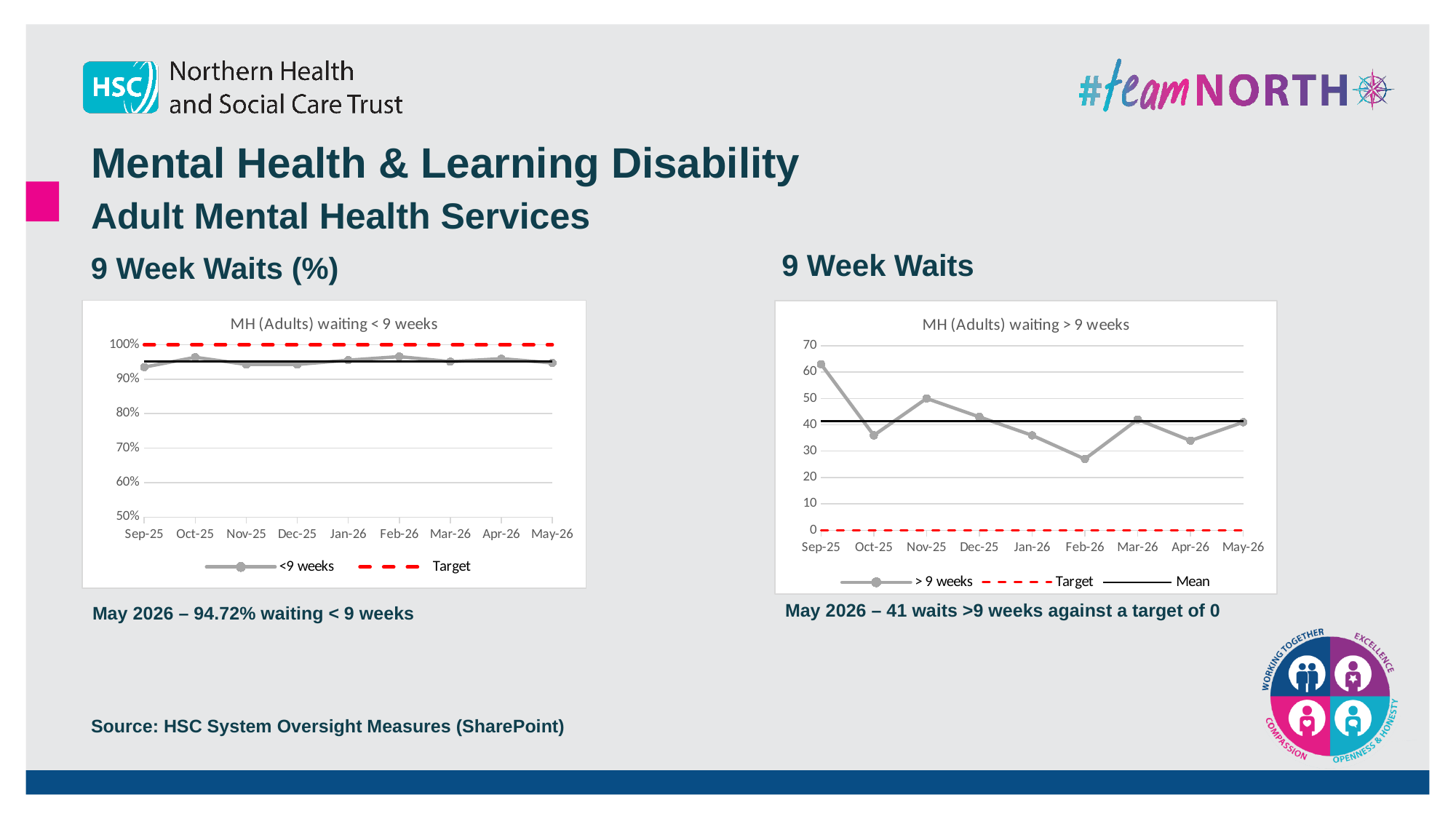
How many series does the legend of the 'MH (Adults) waiting < 9 weeks' chart list? 2 In the 'MH (Adults) waiting > 9 weeks' chart, which month has the highest number of waits? Sep-25 In the 'MH (Adults) waiting > 9 weeks' chart, which month has the lowest number of waits? Feb-26 How many series does the legend of the 'MH (Adults) waiting > 9 weeks' chart list? 3 In the 'MH (Adults) waiting < 9 weeks' chart, what is the value for May-26? 94.72% What kind of chart is the 'MH (Adults) waiting < 9 weeks' chart on the left? line chart In the 'MH (Adults) waiting > 9 weeks' chart, what is the target value shown by the dashed red line? 0 In the 'MH (Adults) waiting < 9 weeks' chart, is the value for Sep-25 greater or less than 90%? greater In the 'MH (Adults) waiting > 9 weeks' chart, is the value for Feb-26 greater or less than 30? less In the 'MH (Adults) waiting > 9 weeks' chart, what is the value for May-26? 41 In the 'MH (Adults) waiting > 9 weeks' chart, is the value for Sep-25 greater or less than 50? greater How many months are plotted on the x axis of the 'MH (Adults) waiting > 9 weeks' chart on the right? 9